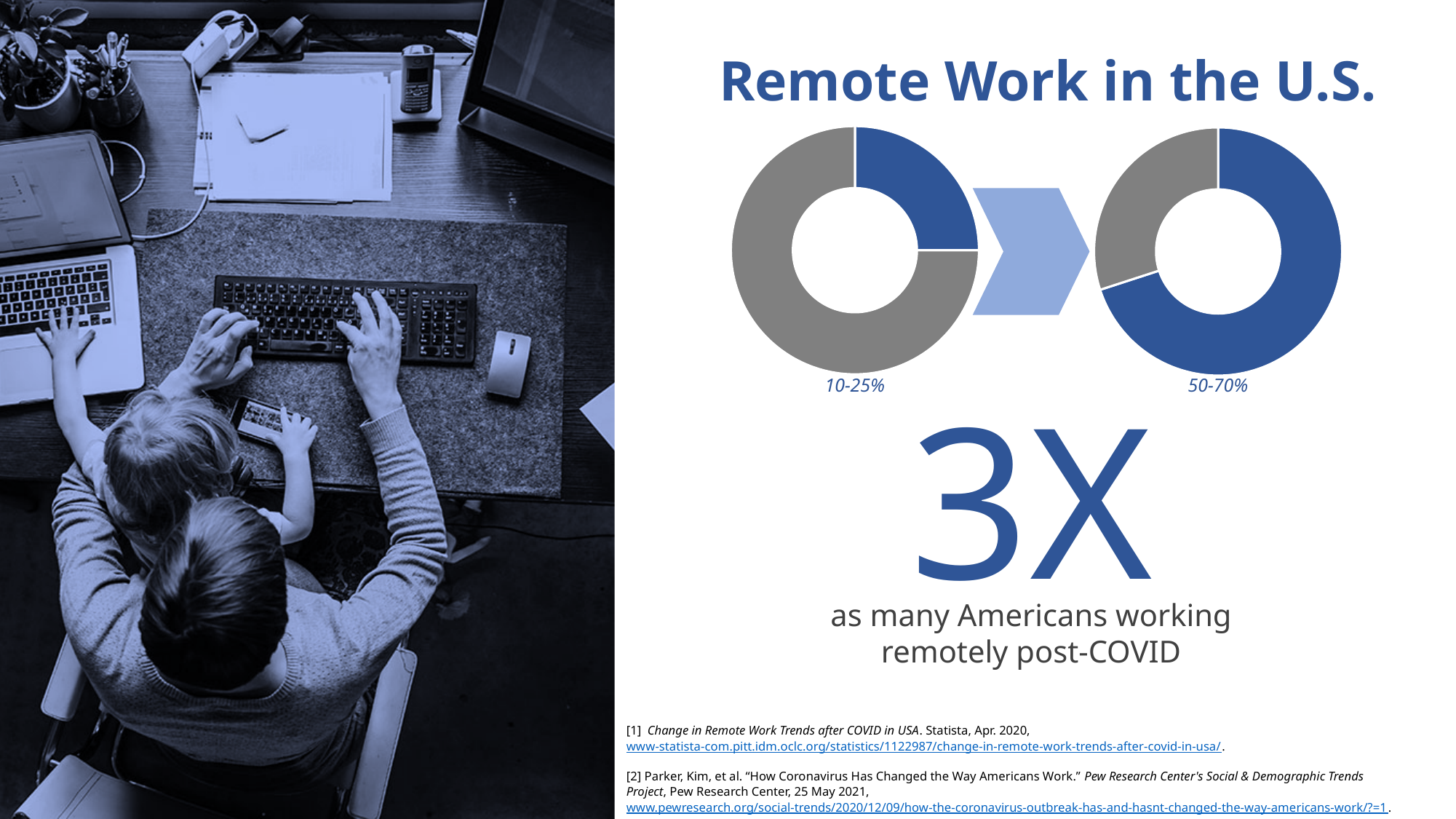
Which donut chart shows the lower range of remote work, the left or the right? the left In the left donut chart, is the blue segment larger or smaller than the grey segment? smaller How many segments does each donut chart have? 2 What value label is printed under the left donut chart? 10-25% Which donut chart has the larger blue segment, the left one or the right one? the right one What kind of chart is used on the slide to show remote work shares? donut chart What is the title above the donut charts? Remote Work in the U.S. How many donut charts are shown on the slide? 2 What multiplier is printed in large text below the donut charts? 3X What value label is printed under the right donut chart? 50-70% In the right donut chart, is the blue segment larger or smaller than the grey segment? larger